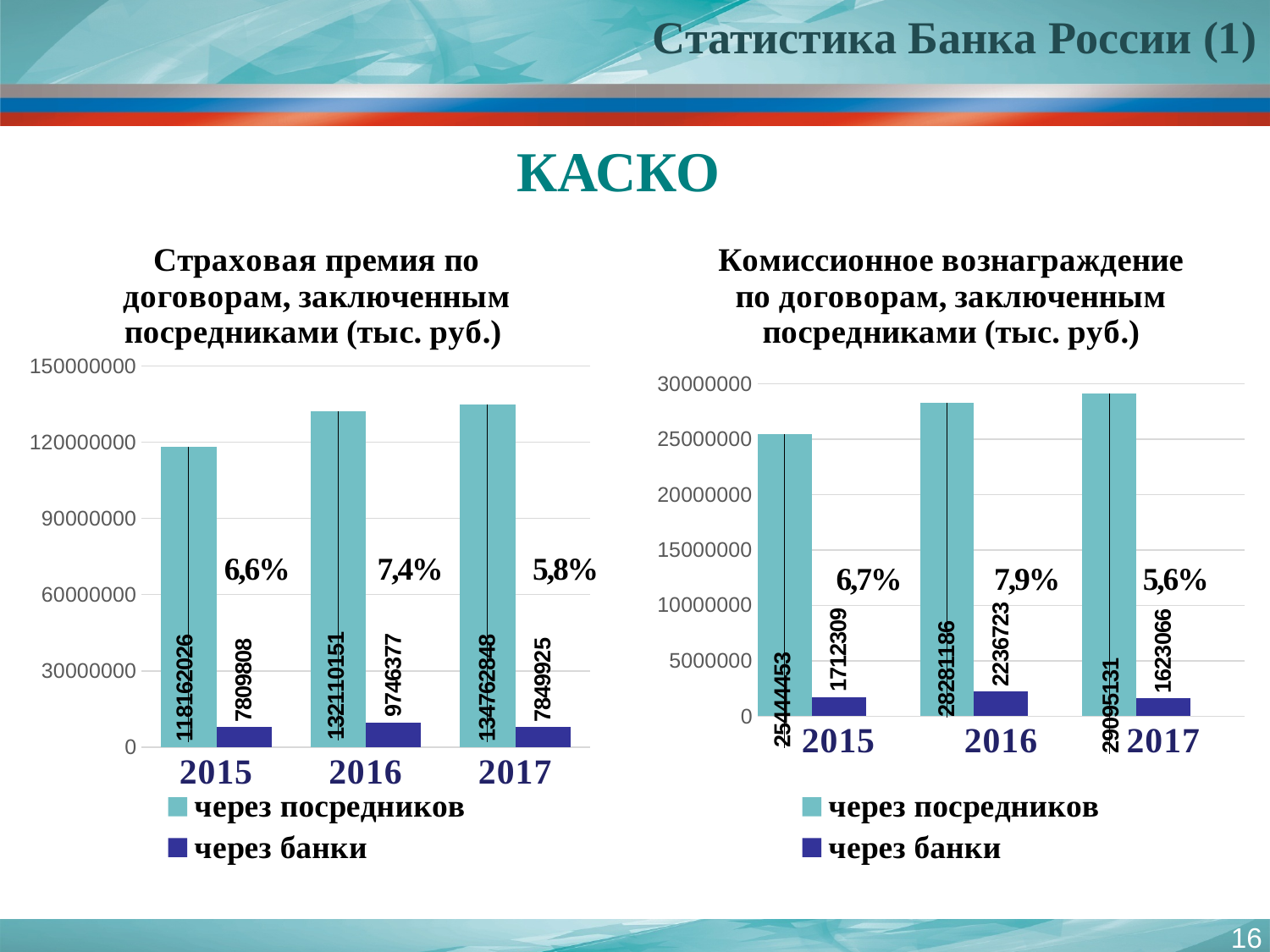
In the left chart (Страховая премия по договорам, заключенным посредниками), what percentage is shown above the 2016 bars? 7,4% In the right chart (Комиссионное вознаграждение по договорам, заключенным посредниками), what is the value for «через банки» in 2015? 1712309 How many series does the legend of the left chart list? 2 In the right chart (Комиссионное вознаграждение по договорам, заключенным посредниками), what is the value for «через посредников» in 2017? 29095131 In the right chart (Комиссионное вознаграждение по договорам, заключенным посредниками), which year has the lowest value for «через банки»? 2017 In the right chart (Комиссионное вознаграждение по договорам, заключенным посредниками), do the «через посредников» values rise or fall from 2015 to 2017? rise In the left chart (Страховая премия по договорам, заключенным посредниками), what is the difference between the «через посредников» values for 2017 and 2015? 16600822 What type of chart is the right chart (Комиссионное вознаграждение по договорам, заключенным посредниками)? bar chart In the left chart (Страховая премия по договорам, заключенным посредниками), what is the value for «через посредников» in 2016? 132110151 In the left chart (Страховая премия по договорам, заключенным посредниками), what is the value for «через банки» in 2017? 7849925 In the right chart (Комиссионное вознаграждение по договорам, заключенным посредниками), is the «через посредников» value for 2015 greater or less than 25000000? greater In the left chart (Страховая премия по договорам, заключенным посредниками), which year has the highest value for «через банки»? 2016